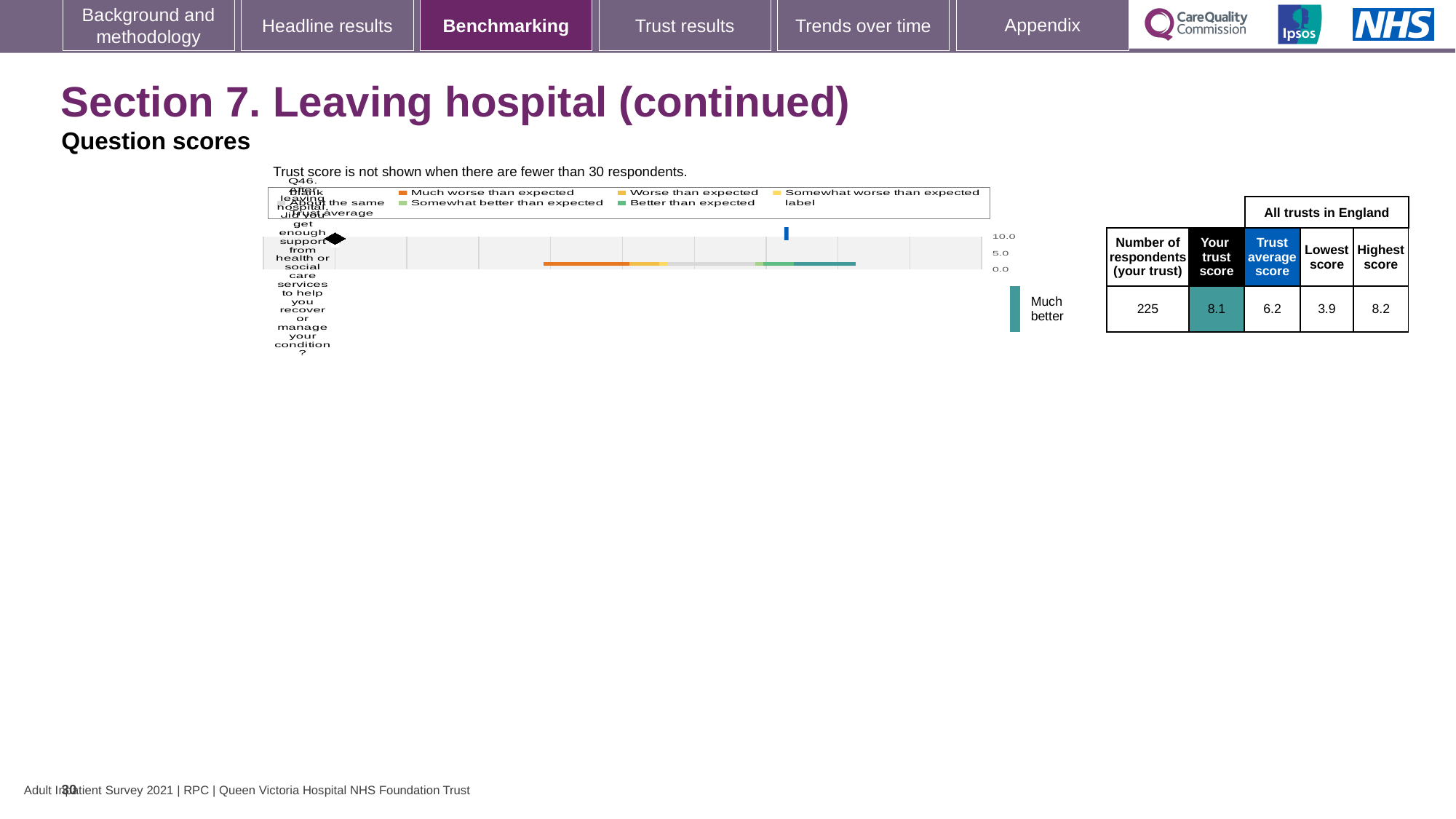
In the table beside the chart, what is the lowest score among all trusts in England for Q46? 3.9 In the table beside the chart, what is the highest score among all trusts in England for Q46? 8.2 In the table beside the chart, what is the trust average score for Q46? 6.2 What kind of chart is shown on the slide? bar chart How many questions (categories) are plotted in the chart? 1 What is the highest value shown on the chart's axis? 10.0 Which is larger for Q46: your trust score or the trust average score? Your trust score In the table beside the chart, what is the number of respondents for your trust for Q46? 225 Which question number is plotted in the chart? Q46 What is the difference between your trust score and the trust average score for Q46? 1.9 In the table beside the chart, what is your trust score for Q46? 8.1